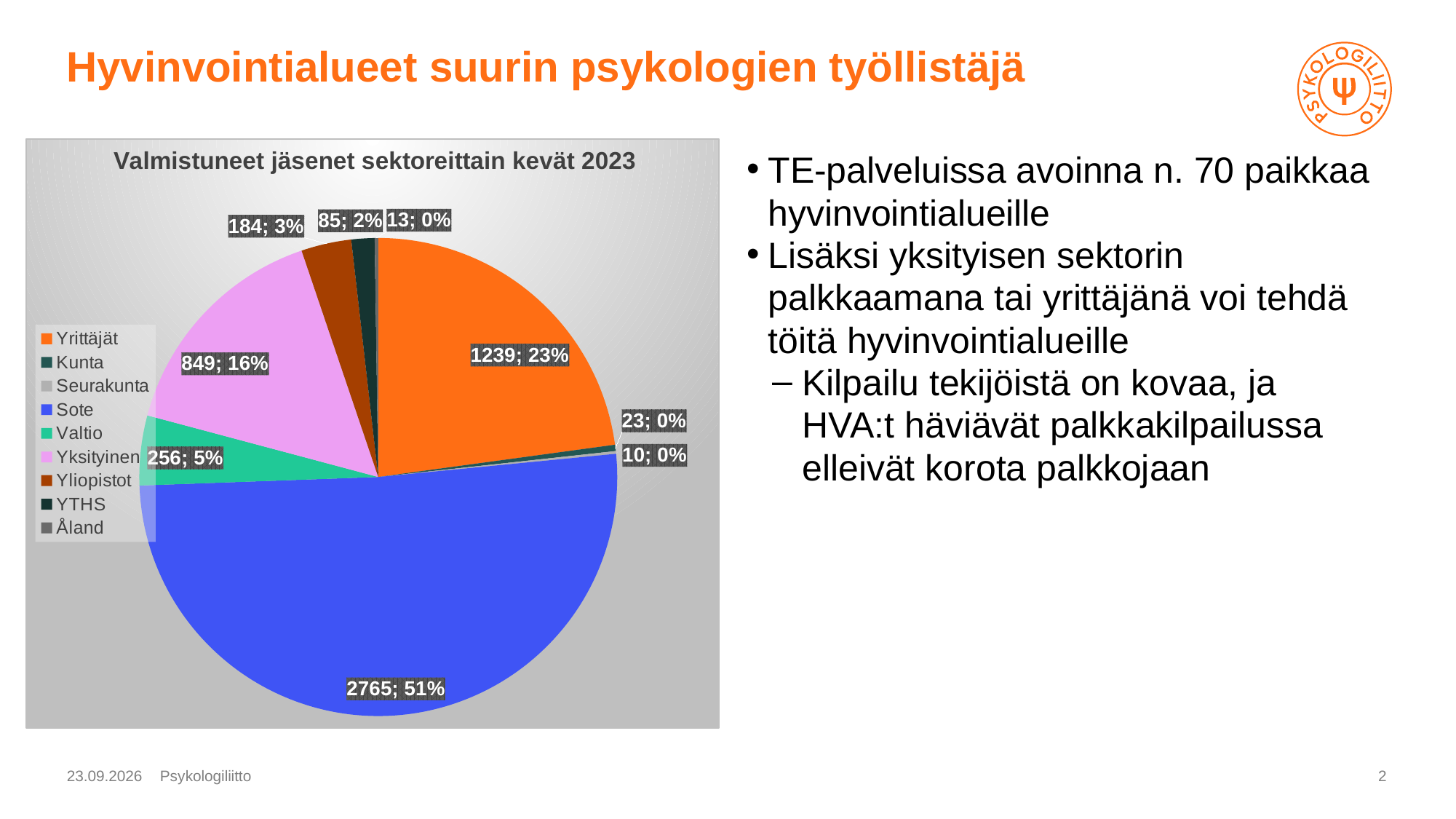
What is the value shown for YTHS? 85 What kind of chart is shown on the slide? pie chart How many categories does the legend of the pie chart list? 9 What is the value shown for Sote? 2765 Which category has the largest slice of the pie chart? Sote Which category has the smallest value in the pie chart? Seurakunta What is the difference between the values for Sote and Yrittäjät? 1526 What is the title of the chart? Valmistuneet jäsenet sektoreittain kevät 2023 What is the value shown for Yrittäjät? 1239 Which is larger, the value for Valtio or the value for Yliopistot? Valtio What percentage share does Yksityinen have in the pie chart? 16% What percentage share does Sote have in the pie chart? 51%